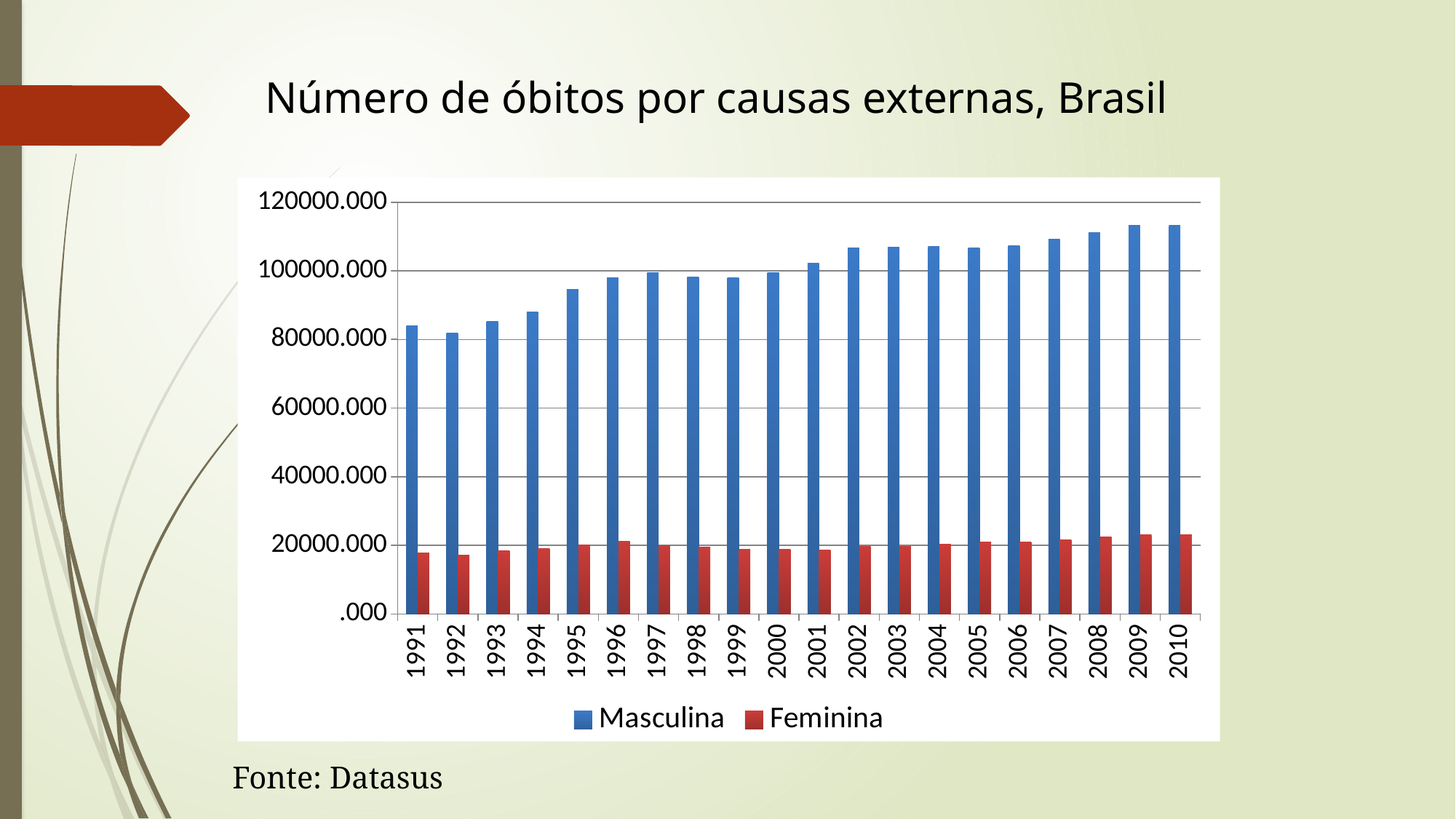
Is the Masculina value for 1995 greater or less than 100000.000? less Which series has the higher values in every year, Masculina or Feminina? Masculina Is the Masculina value for 2010 greater or less than 100000.000? greater Do the Masculina values generally rise or fall from 1991 to 2010? rise What is the title of the chart? Número de óbitos por causas externas, Brasil Which is larger, the Masculina value for 2010 or the Masculina value for 1991? 2010 Is the Masculina value for 1991 greater or less than 80000.000? greater What kind of chart is shown on the slide? bar chart How many series does the legend list? 2 How many years are shown on the x axis? 20